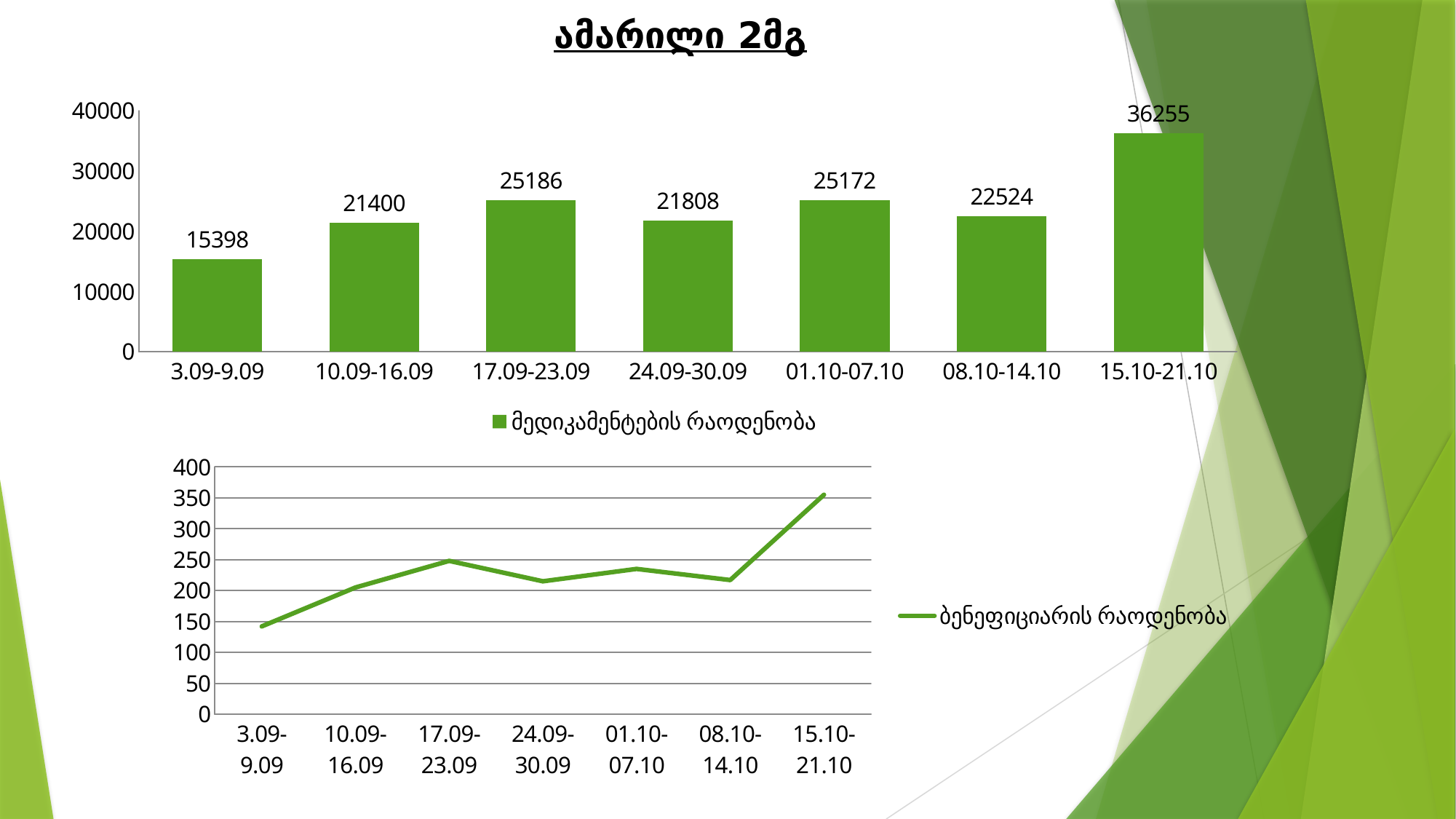
How many bars are in the top bar chart? 7 What is the legend entry of the bottom line chart? ბენეფიციარის რაოდენობა In the top bar chart, which is larger: the value for 10.09-16.09 or the value for 24.09-30.09? 24.09-30.09 In the top bar chart, what is the difference between the values for 15.10-21.10 and 08.10-14.10? 13731 In the top bar chart, what is the value for 15.10-21.10? 36255 In the top bar chart, what is the value for 3.09-9.09? 15398 What type of chart is the bottom chart on the slide? line chart In the top bar chart, what is the value for 24.09-30.09? 21808 In the top bar chart, which period has the highest value? 15.10-21.10 In the bottom line chart, is the value for 15.10-21.10 greater or less than 300? greater In the top bar chart, which period has the lowest value? 3.09-9.09